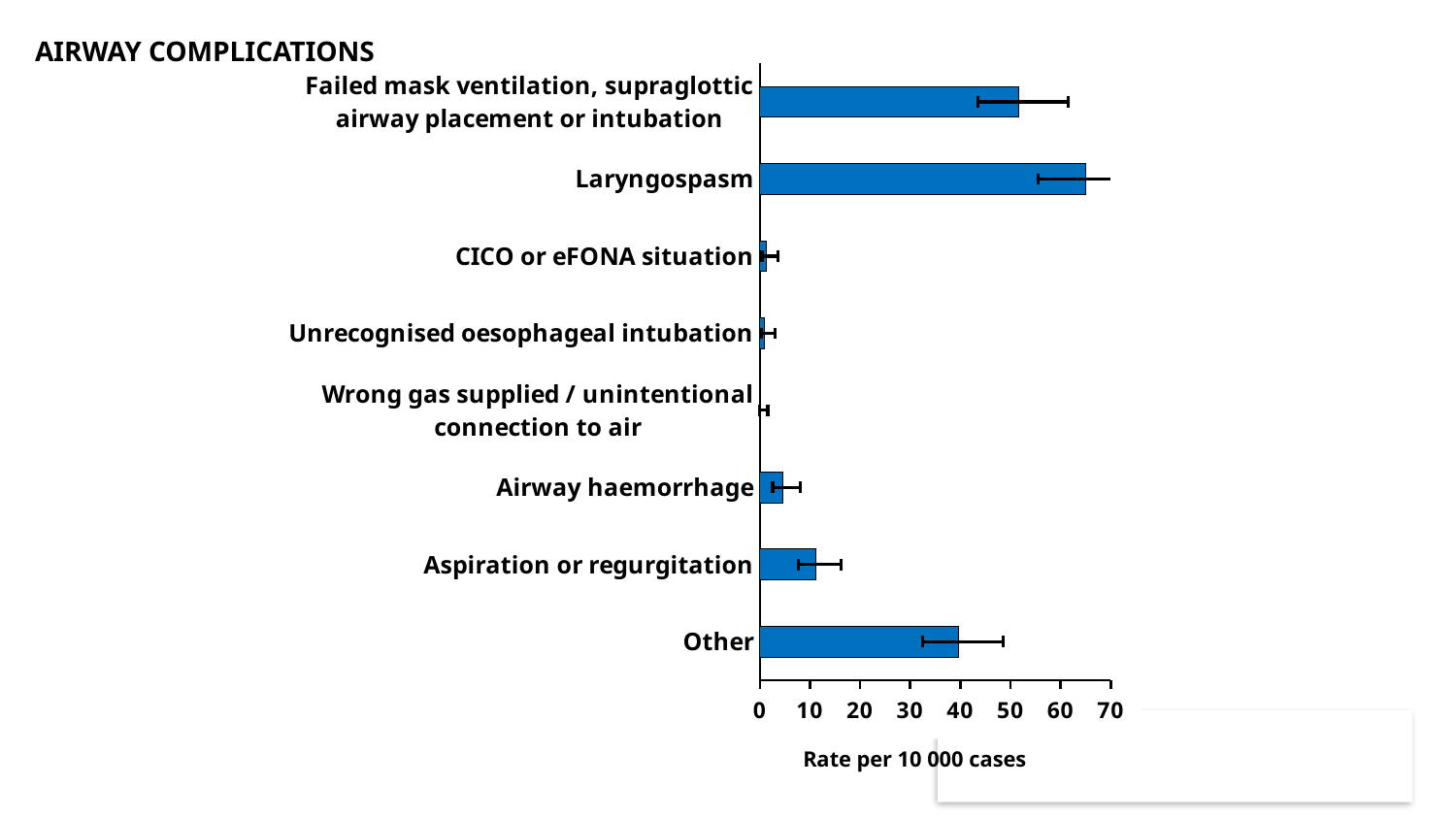
Is the value for Airway haemorrhage greater or less than 10? less Is the value for Other greater or less than 30? greater Which has a higher rate: Laryngospasm or Failed mask ventilation, supraglottic airway placement or intubation? Laryngospasm Is the value for Failed mask ventilation, supraglottic airway placement or intubation greater or less than 40? greater What is the label of the horizontal axis? Rate per 10 000 cases How many complication categories are plotted in the chart? 8 Which has a higher rate: Other or Aspiration or regurgitation? Other Which complication has the highest rate per 10 000 cases? Laryngospasm What is the title of the chart? AIRWAY COMPLICATIONS What kind of chart is shown on the slide? Bar chart